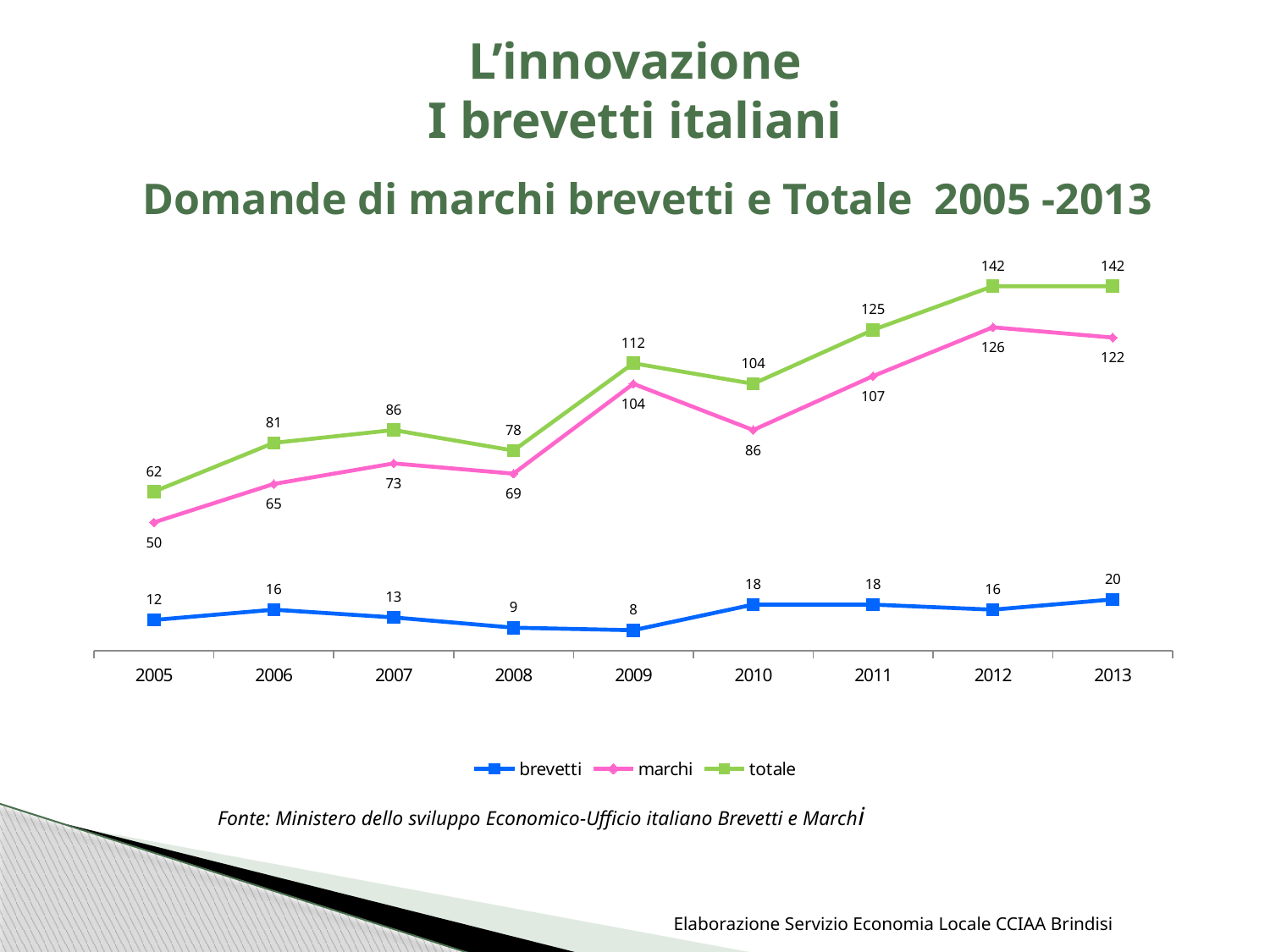
What is the difference between the totale values for 2013 and 2005? 80 What is the value of marchi in 2009? 104 How many years are shown on the x axis? 9 How many series does the legend list? 3 Does the totale series rise or fall between 2009 and 2010? fall Which is larger, marchi in 2010 or marchi in 2011? marchi in 2011 Which series is shown in pink in the legend? marchi What is the value of totale in 2011? 125 What type of chart is shown on the slide? line chart In which year does the marchi series reach its highest value? 2012 In which year is the brevetti series at its lowest? 2009 What is the value of brevetti in 2013? 20